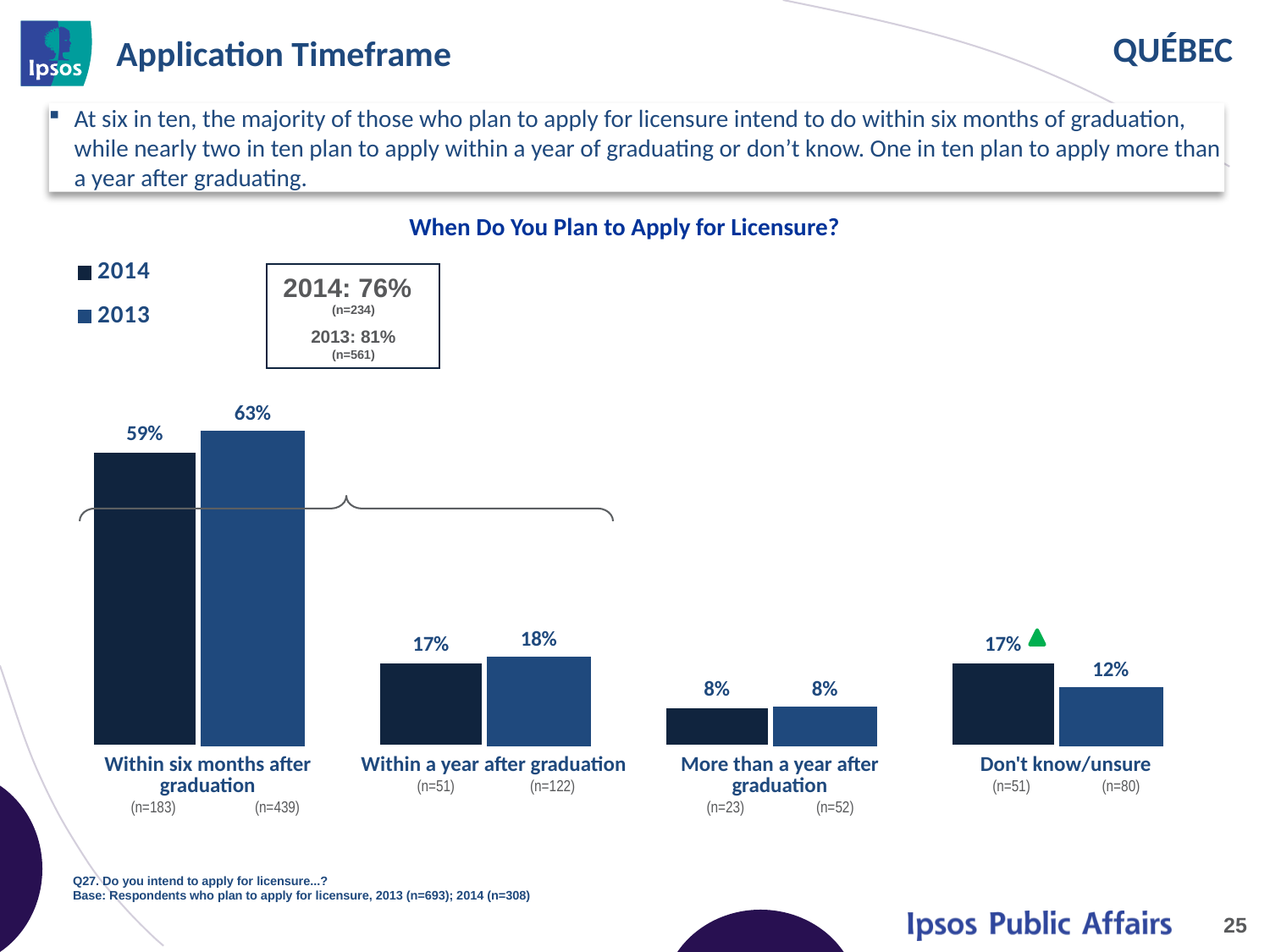
Which category has the highest 2014 value? Within six months after graduation For "Within six months after graduation", which year has the larger value, 2014 or 2013? 2013 How many series does the legend list? 2 What is the 2014 value for "More than a year after graduation"? 8% How many categories are shown on the x axis? 4 What is the 2014 value for "Within six months after graduation"? 59% What is the difference between the 2014 and 2013 values for "Don't know/unsure"? 5% What kind of chart is shown on the slide? Bar chart What is the 2013 value for "Within six months after graduation"? 63% What is the title of the chart? When Do You Plan to Apply for Licensure? What is the 2013 value for "Don't know/unsure"? 12% Which category has the lowest 2013 value? More than a year after graduation